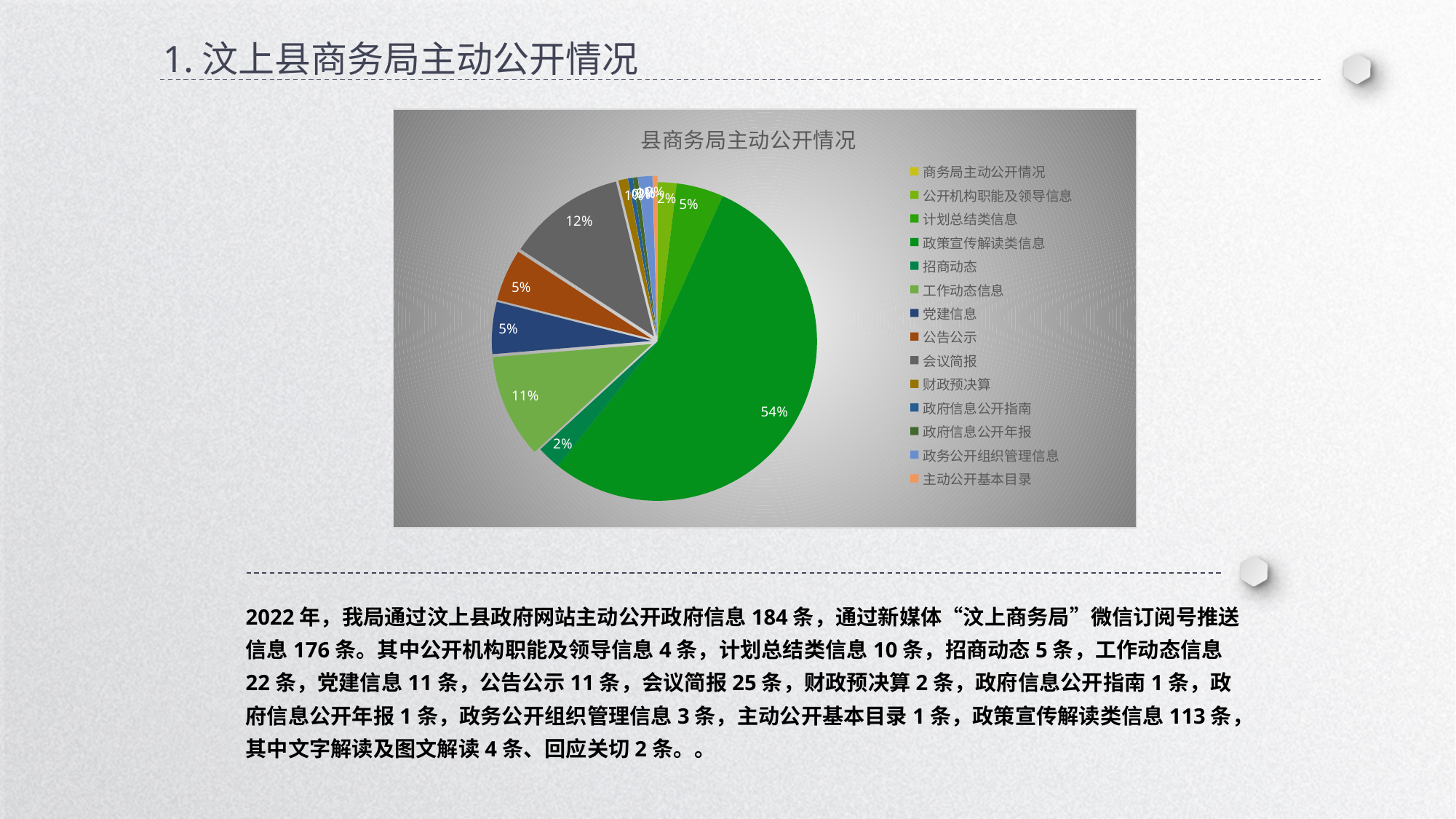
What is the title of the chart? 县商务局主动公开情况 What share of the pie does 会议简报 account for? 12% What share of the pie does 计划总结类信息 account for? 5% What share of the pie does 政策宣传解读类信息 account for? 54% How many categories does the legend list? 14 What kind of chart is shown on the slide? pie chart What is the difference in percentage points between the share of 政策宣传解读类信息 and the share of 会议简报? 42 Which category has the largest share of the pie? 政策宣传解读类信息